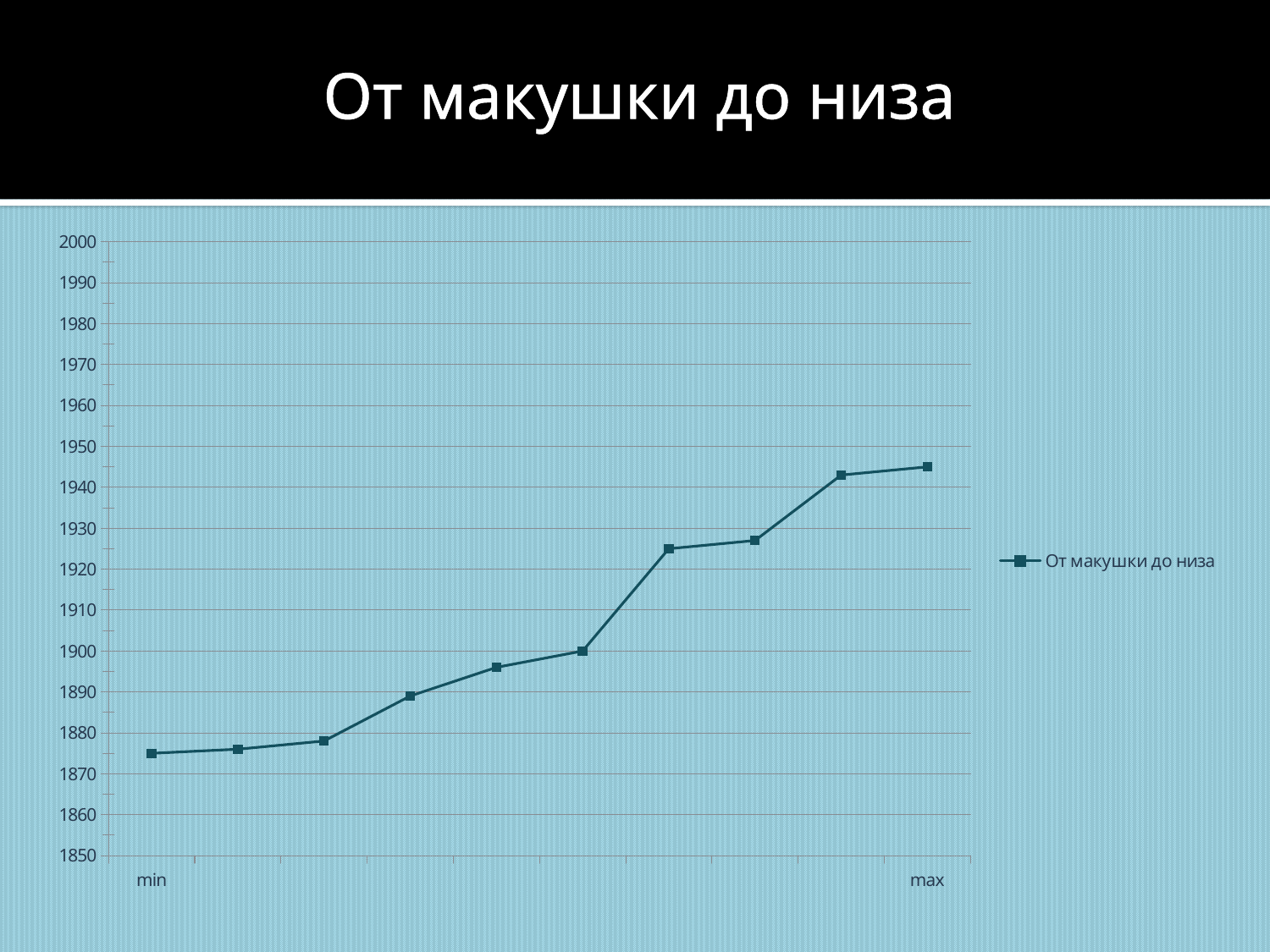
Do the values rise or fall from min to max along the x axis? rise Is the value at "max" greater or less than 1940? greater How many series does the legend list? 1 Which x-axis category has the lowest value? min Which is larger, the value at "min" or the value at "max"? max Is the value at "min" greater or less than 1870? greater Which x-axis category has the highest value? max Is the value at "max" greater or less than 1950? less What kind of chart is shown on the slide? line chart How many data points are plotted on the line? 10 What is the name of the series shown in the legend? От макушки до низа